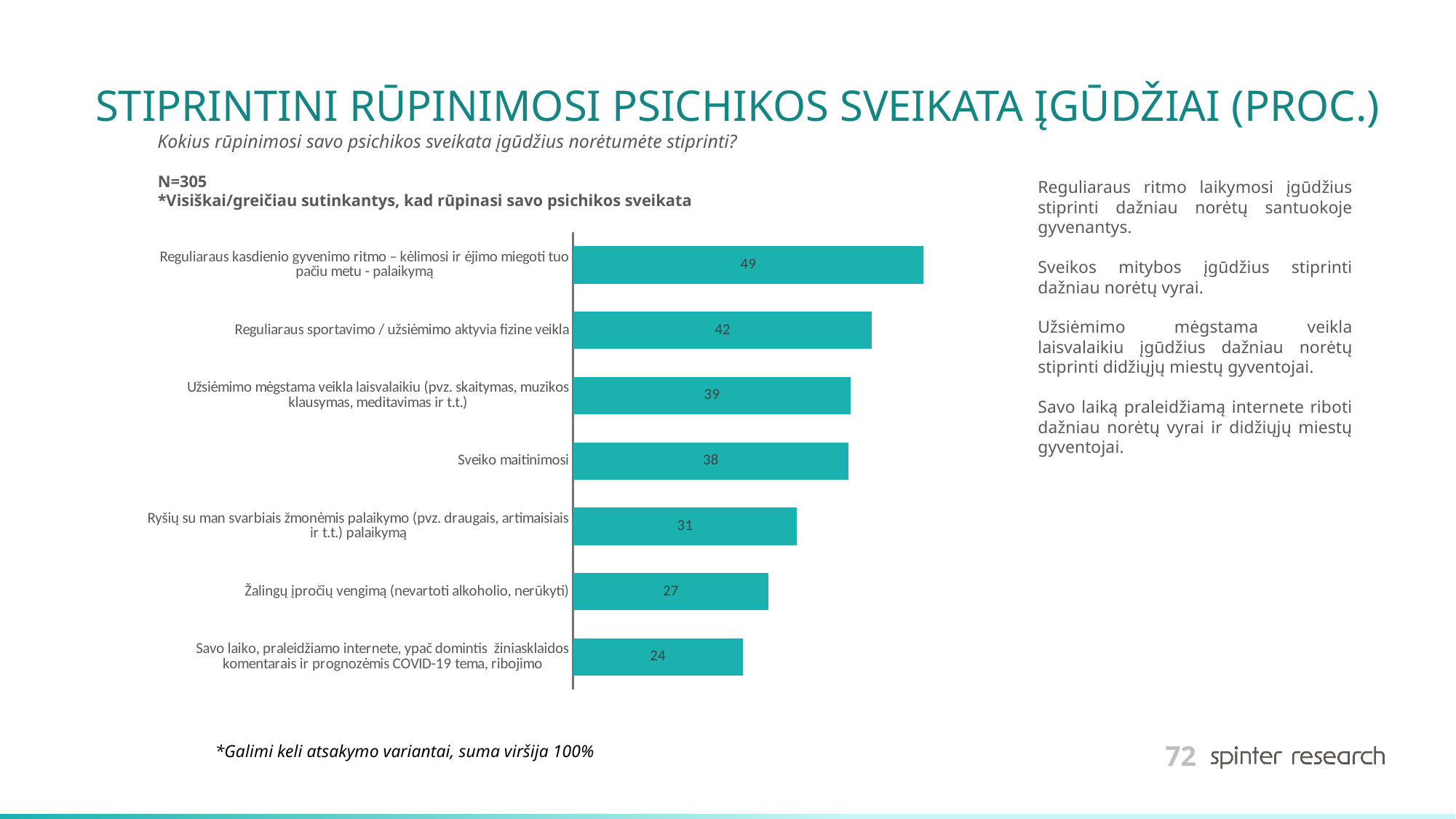
What kind of chart is shown on the slide? Bar chart Which category has the lowest value? Savo laiko, praleidžiamo internete, ypač domintis žiniasklaidos komentarais ir prognozėmis COVID-19 tema, ribojimo What is the difference between the values for "Reguliaraus sportavimo / užsiėmimo aktyvia fizine veikla" and "Sveiko maitinimosi"? 4 How many categories are shown in the chart? 7 Which category has the highest value? Reguliaraus kasdienio gyvenimo ritmo – kėlimosi ir ėjimo miegoti tuo pačiu metu - palaikymą What is the sample size (N) stated on the slide? N=305 What is the value for "Žalingų įpročių vengimą (nevartoti alkoholio, nerūkyti)"? 27 What colour are the bars in the chart? Teal What is the difference between the highest value (49) and the lowest value (24)? 25 What is the value for "Reguliaraus sportavimo / užsiėmimo aktyvia fizine veikla"? 42 What is the value for "Sveiko maitinimosi"? 38 Which is larger: the value for "Ryšių su man svarbiais žmonėmis palaikymo" or for "Žalingų įpročių vengimą"? Ryšių su man svarbiais žmonėmis palaikymo